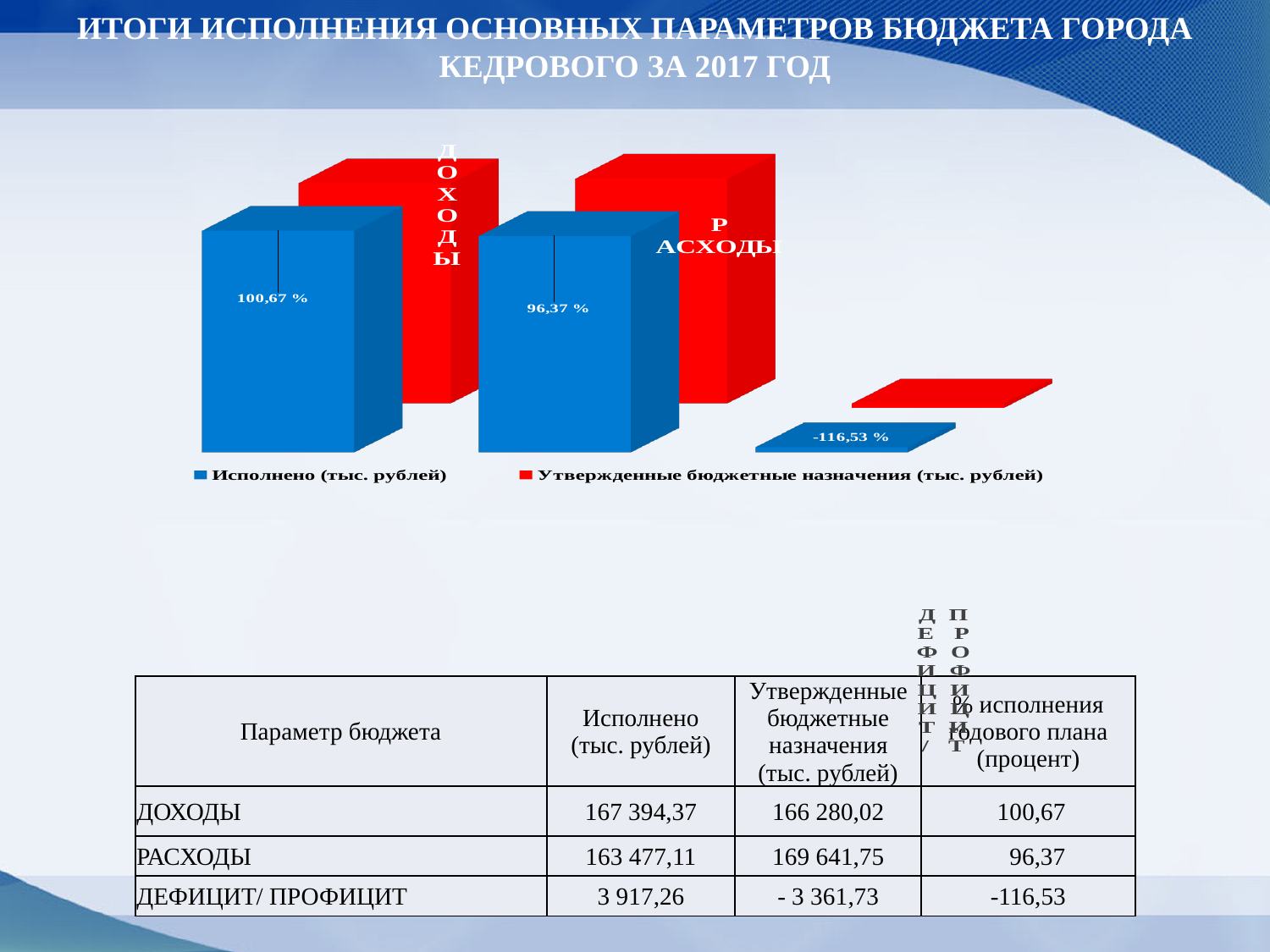
How many categories are plotted in the chart? 3 What is the difference between the percentage labels on the ДОХОДЫ and РАСХОДЫ Исполнено bars? 4,30 % Which has the larger percentage label on its Исполнено bar, ДОХОДЫ or РАСХОДЫ? ДОХОДЫ What percentage label is shown on the third (deficit/surplus) Исполнено bar in the chart? -116,53 % What percentage label is shown on the Исполнено bar for РАСХОДЫ? 96,37 % What is the title of the slide containing the chart? ИТОГИ ИСПОЛНЕНИЯ ОСНОВНЫХ ПАРАМЕТРОВ БЮДЖЕТА ГОРОДА КЕДРОВОГО ЗА 2017 ГОД Which category has the lowest bars in the chart? ДЕФИЦИТ/ПРОФИЦИТ (the third category) What kind of chart is shown on the slide? bar chart What are the two series named in the chart legend? Исполнено (тыс. рублей) and Утвержденные бюджетные назначения (тыс. рублей) Is the percentage label on the РАСХОДЫ Исполнено bar greater or less than 100? less What percentage label is shown on the Исполнено bar for ДОХОДЫ? 100,67 % How many series does the chart legend list? 2